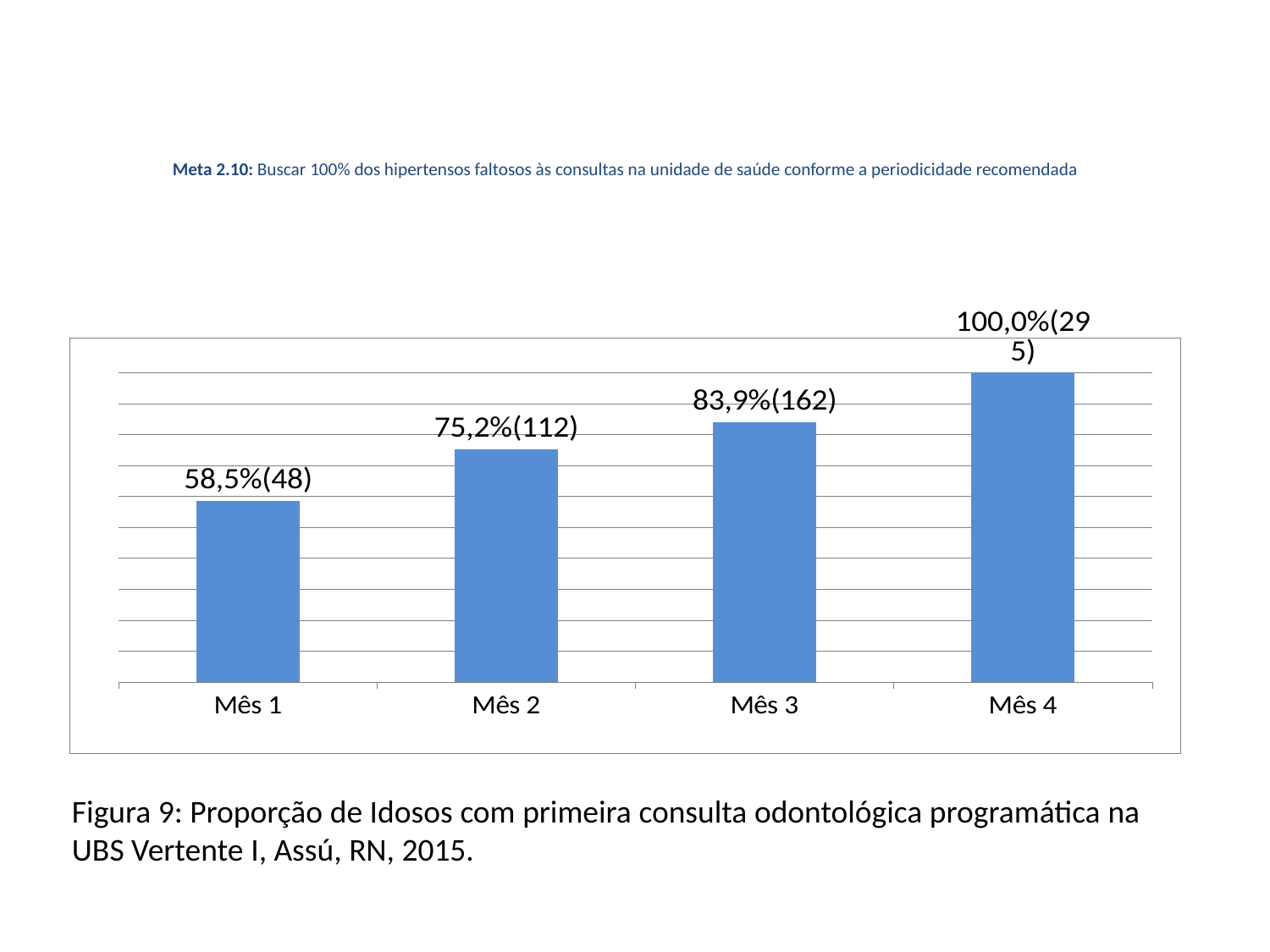
Which is larger, the value for Mês 2 or the value for Mês 3? Mês 3 What value is shown for Mês 3? 83,9%(162) What value is shown for Mês 2? 75,2%(112) Which month has the lowest value? Mês 1 What value is shown for Mês 1? 58,5%(48) Which month has the highest value? Mês 4 What value is shown for Mês 4? 100,0%(295) What kind of chart is shown on the slide? Bar chart What is the difference in percentage between Mês 4 and Mês 1? 41,5 percentage points How many months are shown on the chart? 4 What is the difference in percentage between Mês 3 and Mês 2? 8,7 percentage points Do the values rise or fall from Mês 1 to Mês 4? Rise